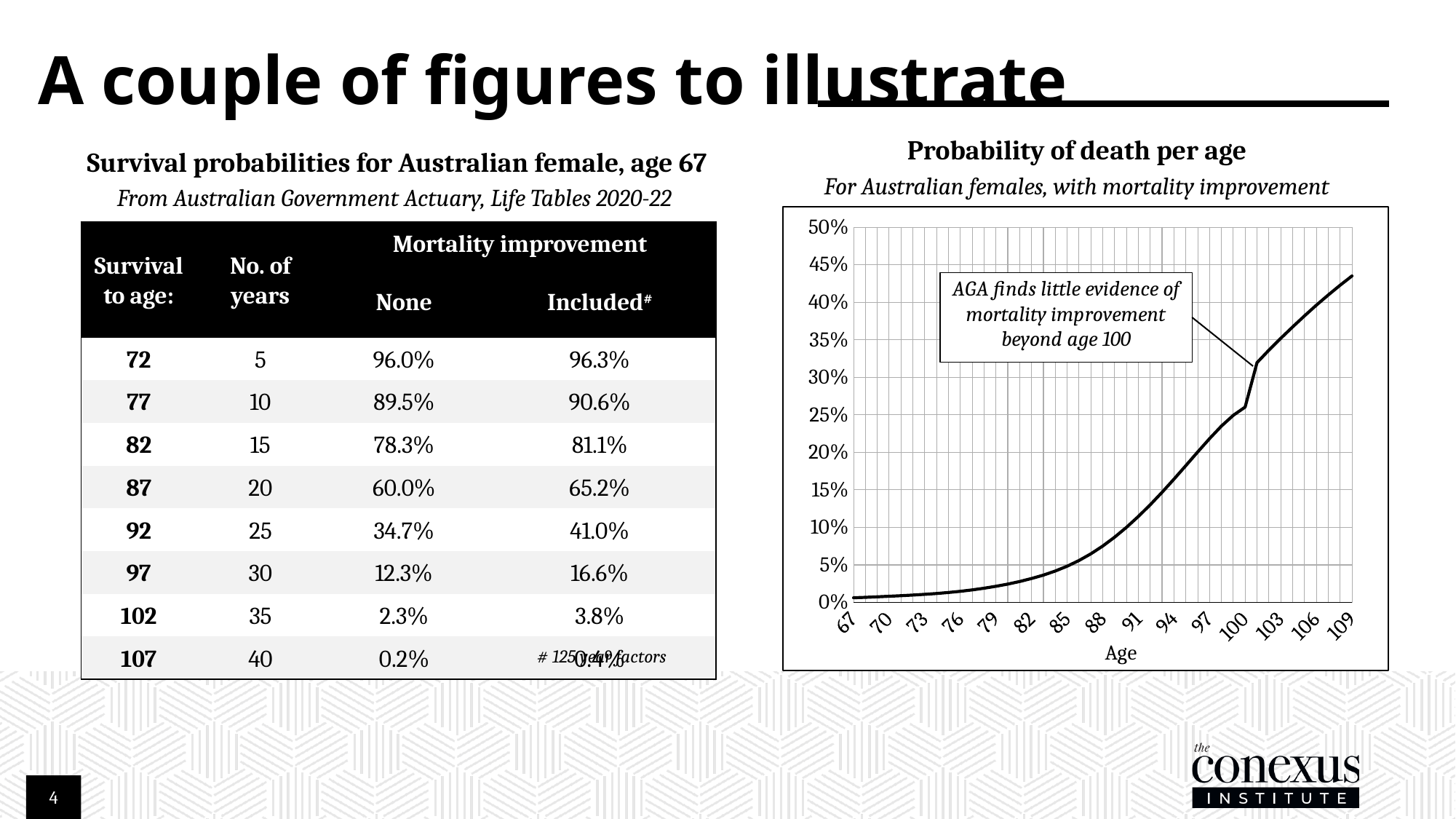
What is the x-axis title of the 'Probability of death per age' chart? Age How many age labels are shown on the x axis of the 'Probability of death per age' chart? 15 In the 'Probability of death per age' chart, is the value at age 91 greater or less than 15%? less In the 'Probability of death per age' chart, which labelled age has the highest probability of death? 109 In the 'Probability of death per age' chart, does the probability of death rise or fall as age increases? rises In the 'Probability of death per age' chart, is the value at age 109 greater or less than 40%? greater In the 'Probability of death per age' chart, is the value at age 67 greater or less than 5%? less In the 'Probability of death per age' chart, which labelled age has the lowest probability of death? 67 What kind of chart is the 'Probability of death per age' chart? line chart In the 'Probability of death per age' chart, is the value at age 97 larger or smaller than the value at age 82? larger